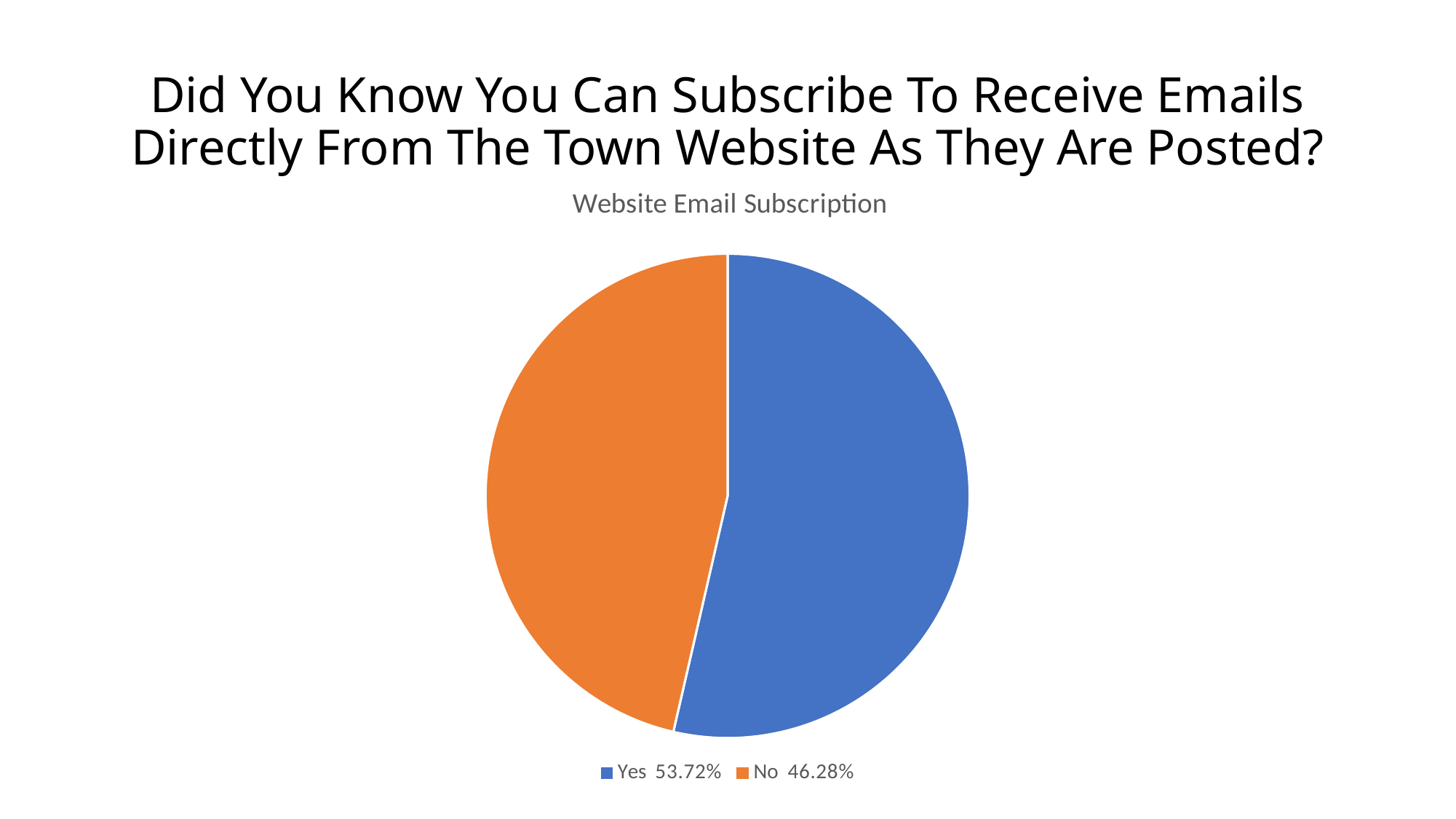
What colour is the Yes slice? blue What percentage of respondents answered No? 46.28% How many slices does the pie chart have? 2 Is the share for Yes larger or smaller than the share for No? larger What is the difference in percentage points between the Yes and No shares? 7.44 Which response has the smaller share of the pie? No What type of chart is shown on the slide? pie chart Which response has the larger share of the pie? Yes How many entries does the legend list? 2 What is the chart's title? Website Email Subscription Is the share for No greater or less than 50%? less What percentage of respondents answered Yes? 53.72%